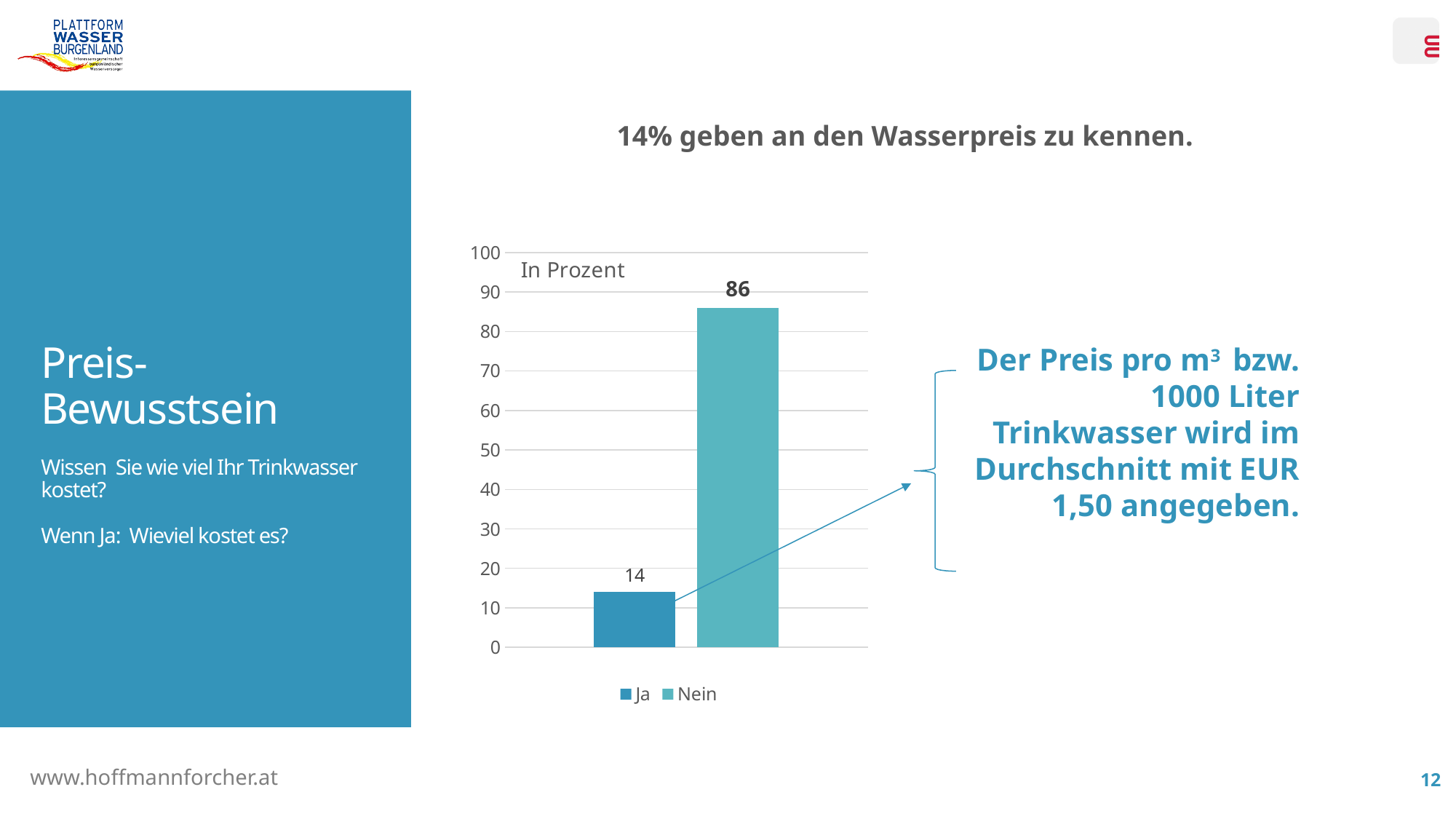
What is the value for Ja? 14 Is the value for Ja greater or less than 20? less Is the value for Nein greater or less than 80? greater Which series has the lowest value? Ja How many series does the legend list? 2 Which series has the highest value? Nein Which is larger, the value for Ja or the value for Nein? Nein What is the total of the values for Ja and Nein? 100 What kind of chart is shown on the slide? bar chart What is the value for Nein? 86 What is the difference between the values for Nein and Ja? 72 What unit label is shown inside the chart area? In Prozent